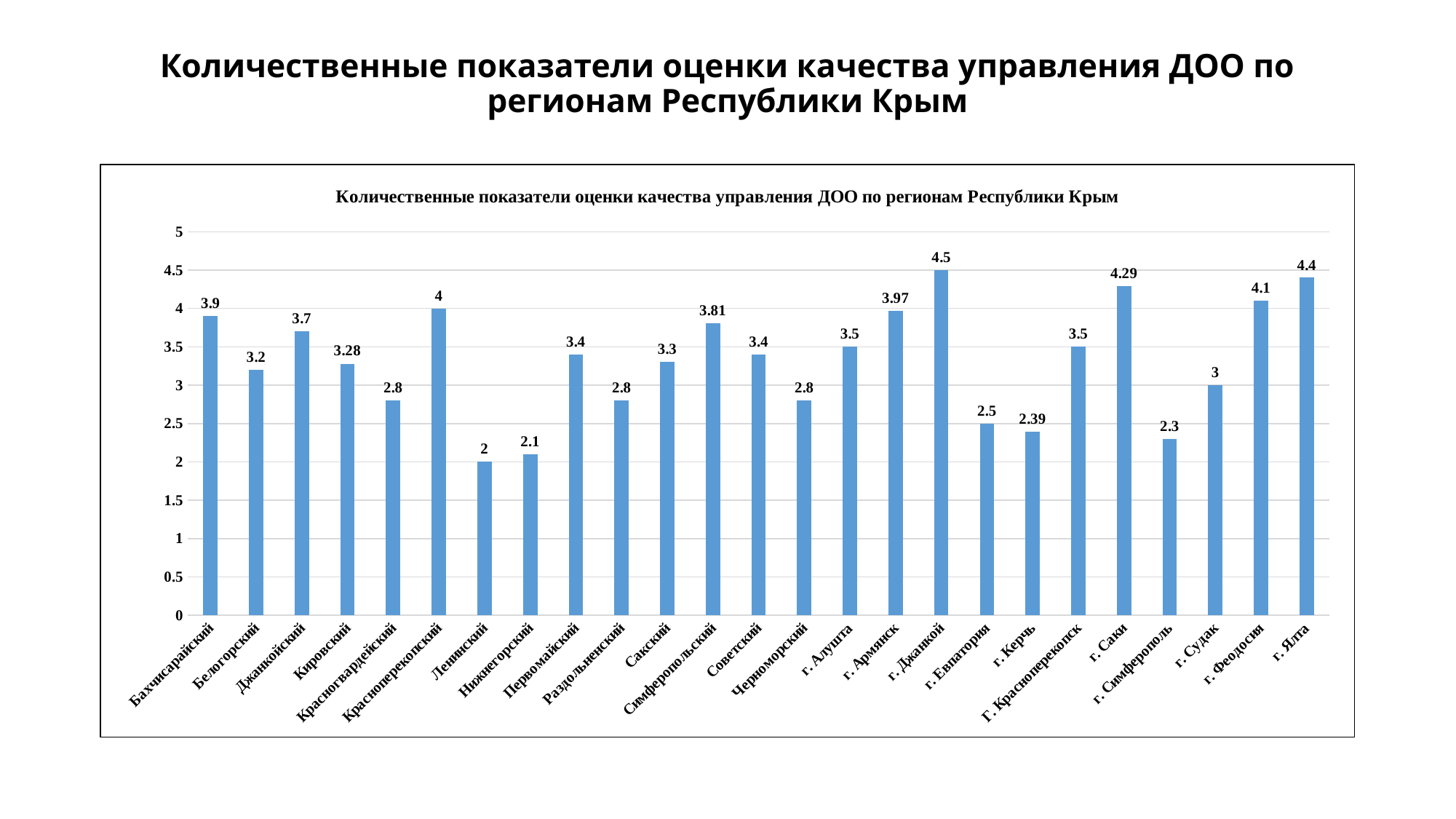
How many regions are shown on the chart? 25 What is the value for Кировский? 3.28 Which has a larger value, г. Саки or г. Феодосия? г. Саки What is the value for г. Керчь? 2.39 What is the title of the chart? Количественные показатели оценки качества управления ДОО по регионам Республики Крым Which region has the highest value? г. Джанкой Which region has the lowest value? Ленинский Is the value for г. Армянск greater or less than 3.5? greater What is the difference between the values for г. Ялта and г. Симферополь? 2.1 What kind of chart is shown on the slide? bar chart What is the value for Симферопольский? 3.81 What is the value for г. Джанкой? 4.5